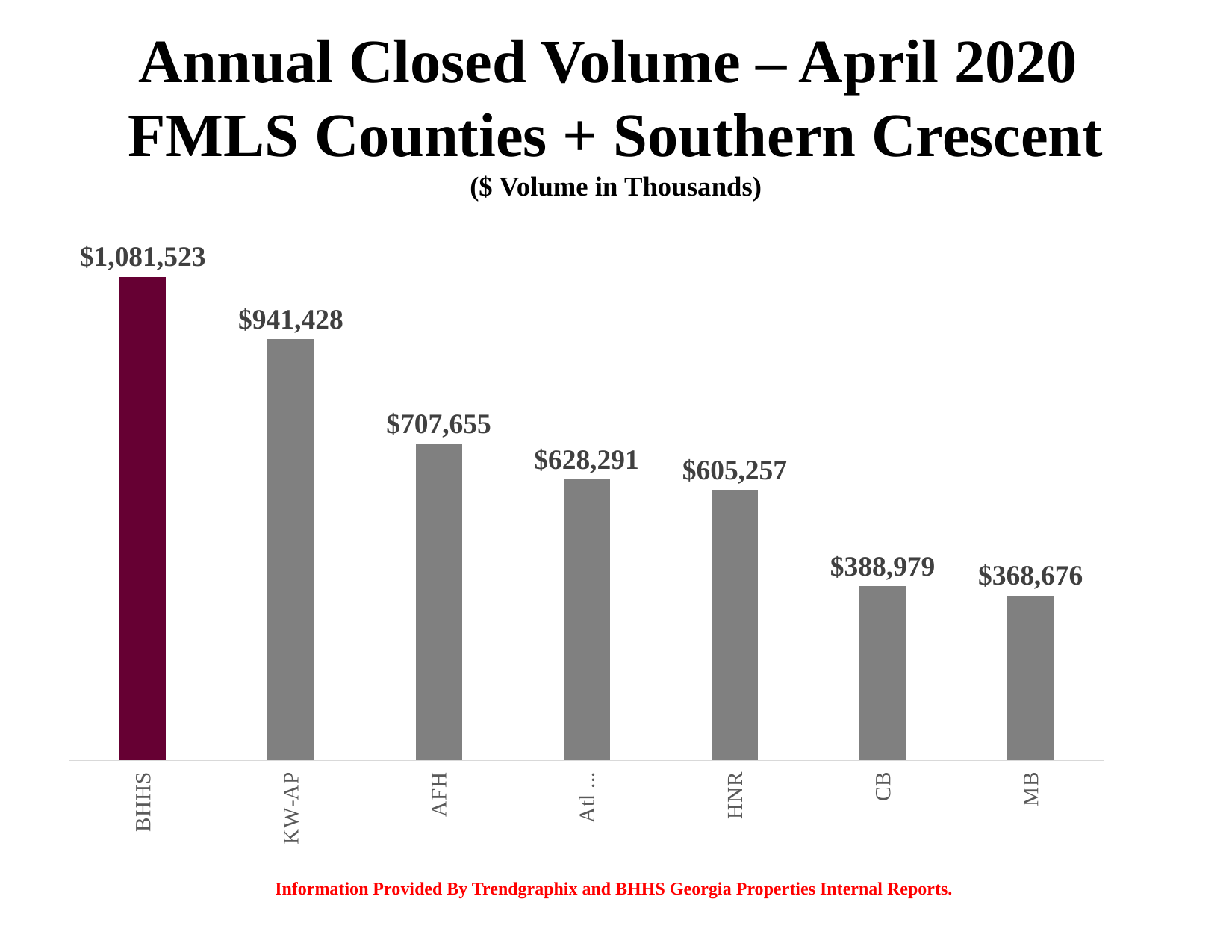
What is the annual closed volume shown for HNR? $605,257 What is the annual closed volume shown for KW-AP? $941,428 Which bar is shown in a different colour from the others? BHHS Which is larger, the value for AFH or the value for HNR? AFH What is the difference between the BHHS and KW-AP values? $140,095 What kind of chart is shown on the slide? Bar chart What is the annual closed volume shown for BHHS? $1,081,523 Which company has the lowest annual closed volume on the chart? MB Which company has the highest annual closed volume on the chart? BHHS What is the annual closed volume shown for MB? $368,676 How many companies are shown on the chart? 7 What is the difference between the CB and MB values? $20,303